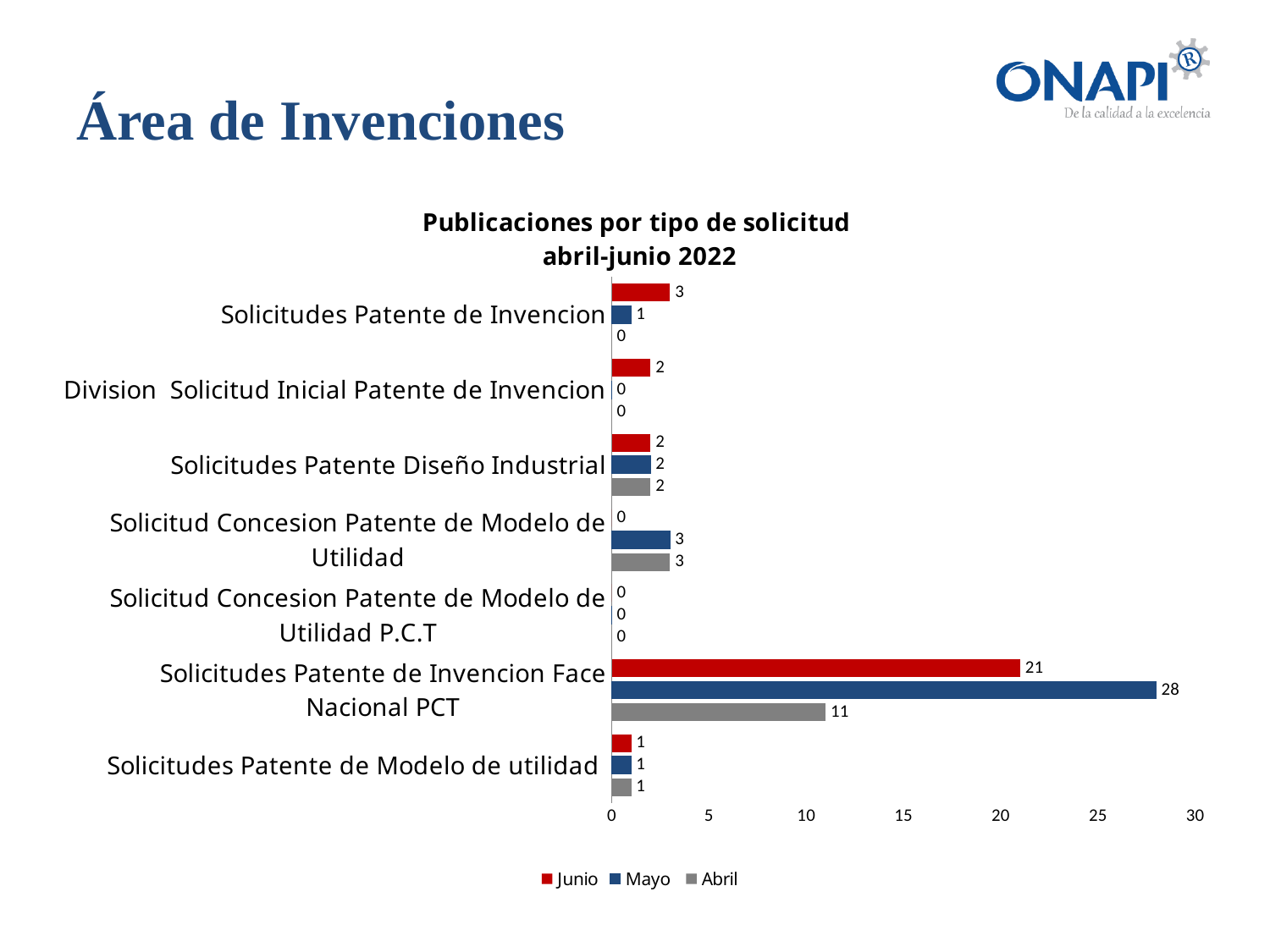
What is the Mayo value for Solicitud Concesion Patente de Modelo de Utilidad? 3 Which is larger for Solicitudes Patente de Invencion Face Nacional PCT, the Junio value or the Mayo value? Mayo How many categories are shown on the y axis? 7 How many series does the legend list? 3 What is the Abril value for Solicitudes Patente de Invencion Face Nacional PCT? 11 What is the Mayo value for Solicitudes Patente de Invencion Face Nacional PCT? 28 What kind of chart is shown? bar chart Which category has the highest Junio value? Solicitudes Patente de Invencion Face Nacional PCT Is the Mayo value for Solicitudes Patente de Invencion Face Nacional PCT greater or less than 25? greater What is the title of the chart? Publicaciones por tipo de solicitud abril-junio 2022 What is the difference between the Mayo and Abril values for Solicitudes Patente de Invencion Face Nacional PCT? 17 What is the Junio value for Solicitudes Patente de Invencion? 3